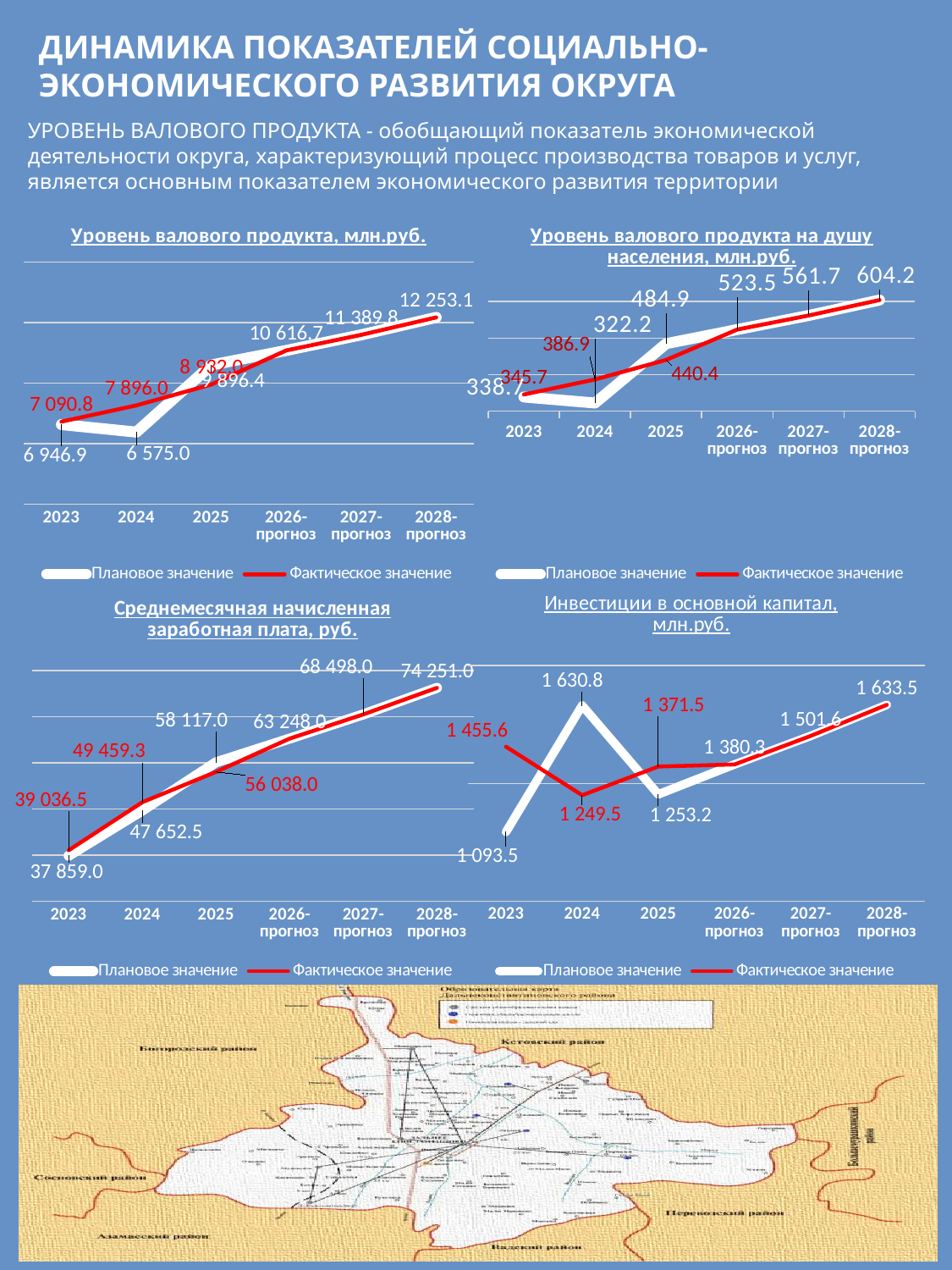
In the 'Среднемесячная начисленная заработная плата, руб.' chart, does the 'Плановое значение' rise or fall from 2023 to 2028-прогноз? rise In the 'Среднемесячная начисленная заработная плата, руб.' chart, what is the 'Плановое значение' for 2023? 37 859.0 In the 'Уровень валового продукта, млн.руб.' chart, what is the 'Фактическое значение' for 2023? 7 090.8 What kind of chart is 'Уровень валового продукта, млн.руб.'? line chart In the 'Инвестиции в основной капитал, млн.руб.' chart, what is the 'Фактическое значение' for 2023? 1 455.6 In the 'Уровень валового продукта, млн.руб.' chart, what is the 'Плановое значение' for 2028-прогноз? 12 253.1 In the 'Инвестиции в основной капитал, млн.руб.' chart, which year has the lowest 'Плановое значение'? 2023 In the 'Инвестиции в основной капитал, млн.руб.' chart, which is larger for 2024: the 'Плановое значение' or the 'Фактическое значение'? Плановое значение In the 'Уровень валового продукта на душу населения, млн.руб.' chart, what is the 'Плановое значение' for 2028-прогноз? 604.2 How many categories are on the x axis of the 'Среднемесячная начисленная заработная плата, руб.' chart? 6 In the 'Уровень валового продукта, млн.руб.' chart, what is the difference between the 'Плановое значение' for 2028-прогноз and 2027-прогноз? 863.3 How many series does the legend of the 'Инвестиции в основной капитал, млн.руб.' chart list? 2